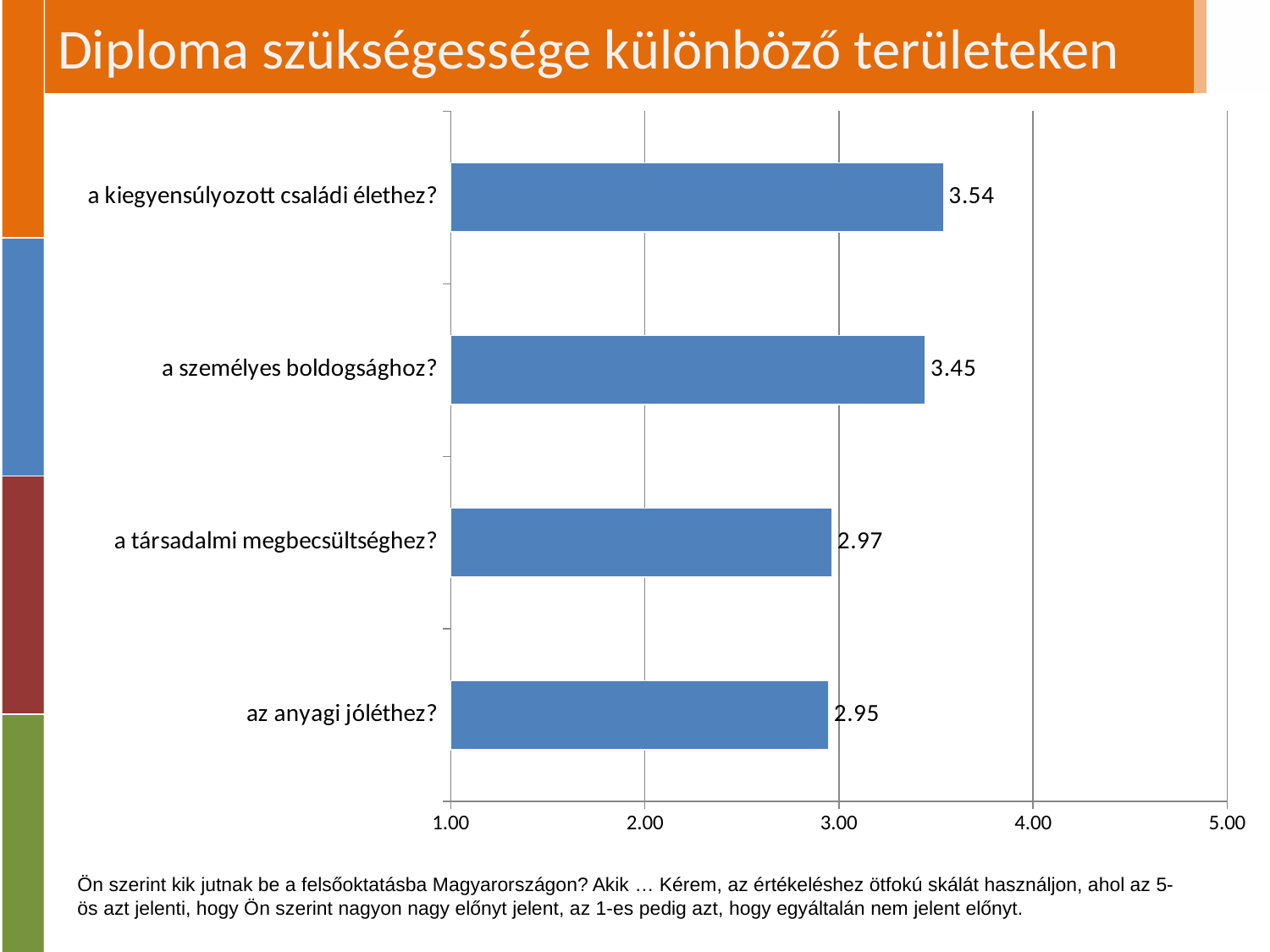
What is the value for "a kiegyensúlyozott családi élethez?"? 3.54 What is the difference between the values for "a személyes boldogsághoz?" and "a társadalmi megbecsültséghez?"? 0.48 Which is larger, the value for "a személyes boldogsághoz?" or the value for "a társadalmi megbecsültséghez?"? a személyes boldogsághoz? Which category has the lowest value? az anyagi jóléthez? How many categories are shown in the chart? 4 What is the value for "a társadalmi megbecsültséghez?"? 2.97 What is the value for "a személyes boldogsághoz?"? 3.45 What kind of chart is shown on the slide? bar chart Which category has the highest value? a kiegyensúlyozott családi élethez? What is the difference between the values for "a kiegyensúlyozott családi élethez?" and "az anyagi jóléthez?"? 0.59 What is the value for "az anyagi jóléthez?"? 2.95 Is the value for "az anyagi jóléthez?" greater or less than 3.00? less